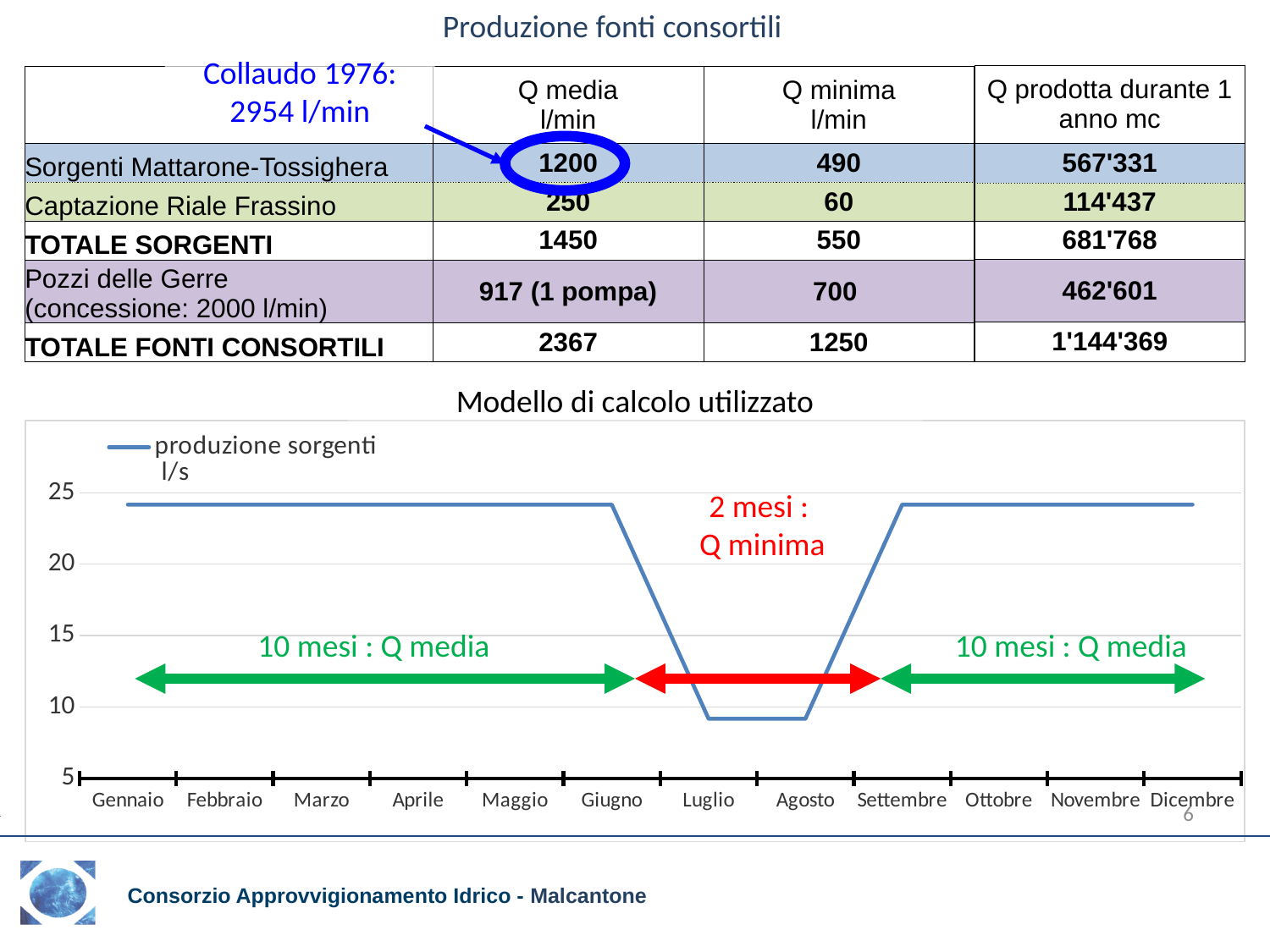
In the 'Modello di calcolo utilizzato' chart, is the value for Agosto greater or less than 15? less In the 'Modello di calcolo utilizzato' chart, which two months have the lowest values? Luglio and Agosto In the 'Modello di calcolo utilizzato' chart, which has the larger value, Agosto or Settembre? Settembre In the 'Modello di calcolo utilizzato' chart, which has the larger value, Giugno or Luglio? Giugno In the 'Modello di calcolo utilizzato' chart, is the value for Dicembre greater or less than 20? greater In the 'Modello di calcolo utilizzato' chart, is the value for Luglio greater or less than 10? less How many months are shown on the x axis of the 'Modello di calcolo utilizzato' chart? 12 How many series does the legend of the 'Modello di calcolo utilizzato' chart list? 1 In the 'Modello di calcolo utilizzato' chart, does the line rise or fall between Giugno and Luglio? Fall What is the legend entry of the series in the 'Modello di calcolo utilizzato' chart? produzione sorgenti l/s What kind of chart is shown under the heading 'Modello di calcolo utilizzato'? Line chart